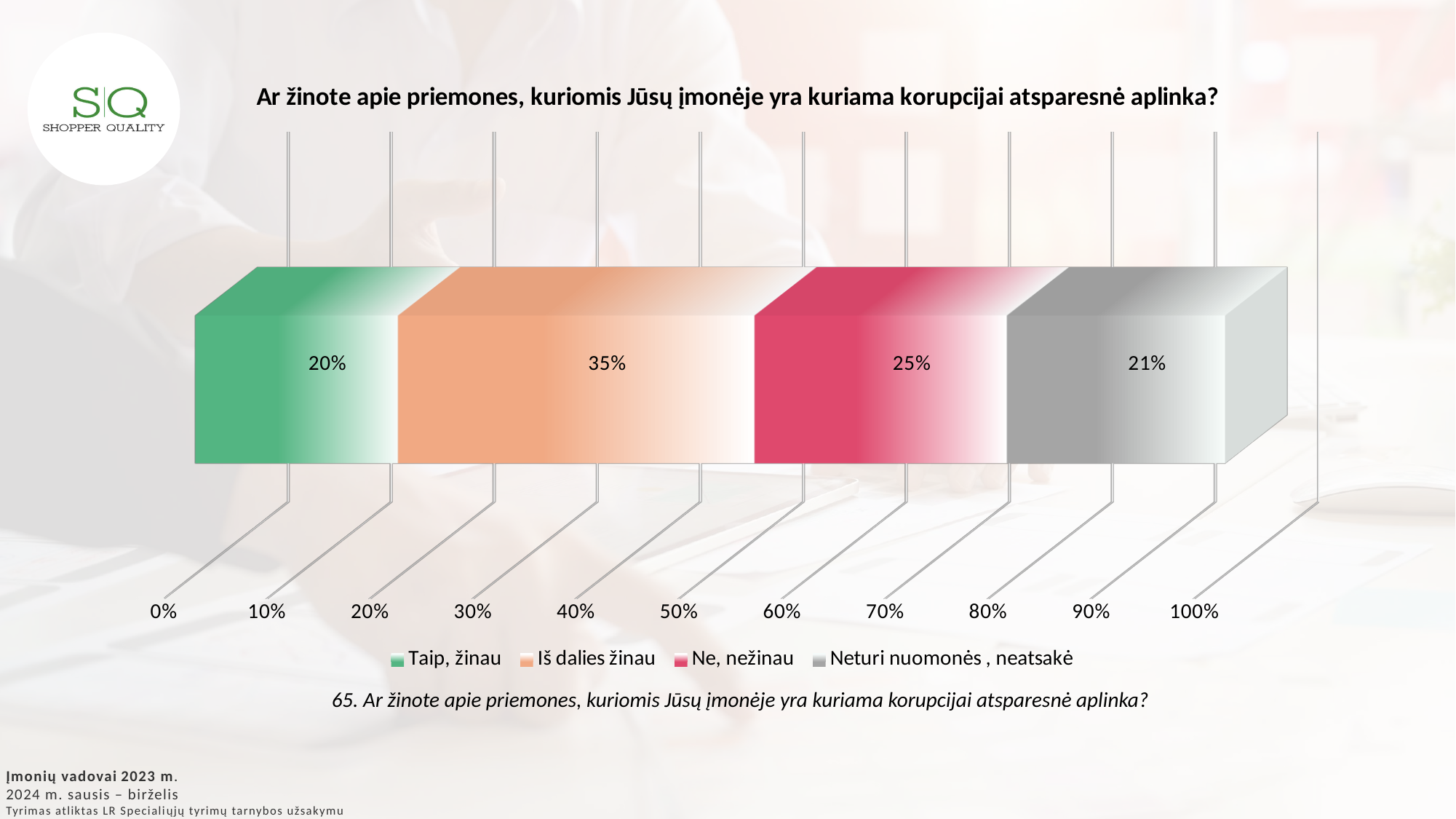
Which answer option has the largest share? Iš dalies žinau What is the combined share of "Taip, žinau" and "Iš dalies žinau"? 55% How many series does the legend list? 4 What percentage of respondents answered "Ne, nežinau"? 25% What percentage of respondents answered "Taip, žinau"? 20% Which is larger: the share for "Ne, nežinau" or the share for "Neturi nuomonės , neatsakė"? Ne, nežinau What colour is the "Ne, nežinau" segment in the chart? Red (pink) What is the difference in percentage points between "Iš dalies žinau" and "Ne, nežinau"? 10 Which answer option has the smallest share? Taip, žinau What percentage of respondents answered "Neturi nuomonės , neatsakė"? 21% What percentage of respondents answered "Iš dalies žinau"? 35% What kind of chart is shown on the slide? Stacked bar chart